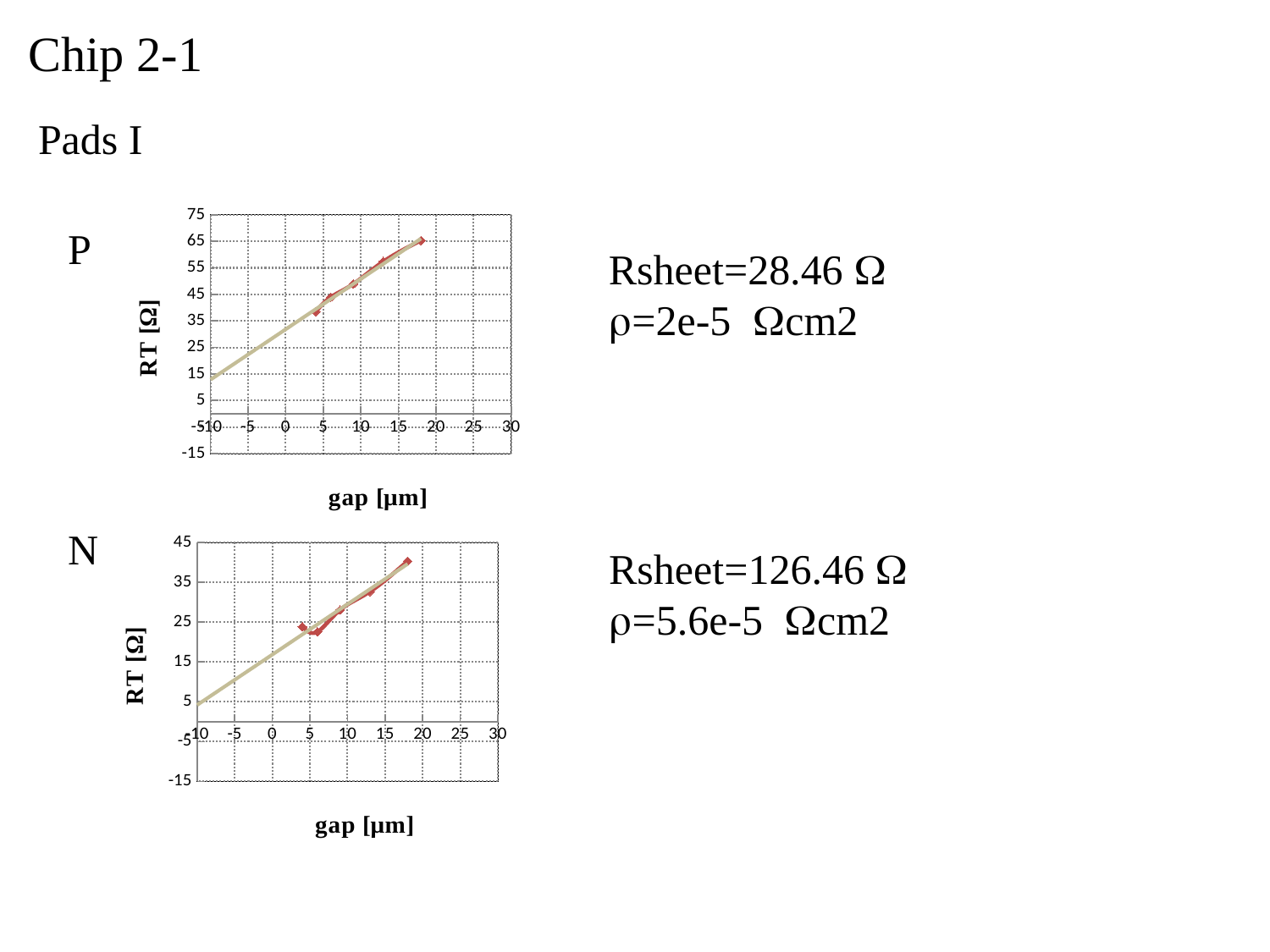
Which chart reaches a higher maximum RT value, the top chart (P) or the bottom chart (N)? the top chart (P) In the bottom chart (N), is the RT value at the smallest gap (about 4 µm) greater or less than 35? less In the bottom chart (N), is the RT value at the largest gap (about 18 µm) greater or less than 35? greater What kind of chart is the top chart labelled P? line chart What is the label of the x axis in the bottom chart (N)? gap [µm] In the top chart (P), is the RT value at the smallest gap (about 4 µm) greater or less than 45? less In the top chart (P), does RT rise or fall as gap increases? rise How many charts are shown on the slide? 2 What is the label of the y axis in the top chart (P)? RT [Ω] What is the highest tick value shown on the y axis of the bottom chart (N)? 45 In the bottom chart (N), does RT rise or fall as gap increases? rise